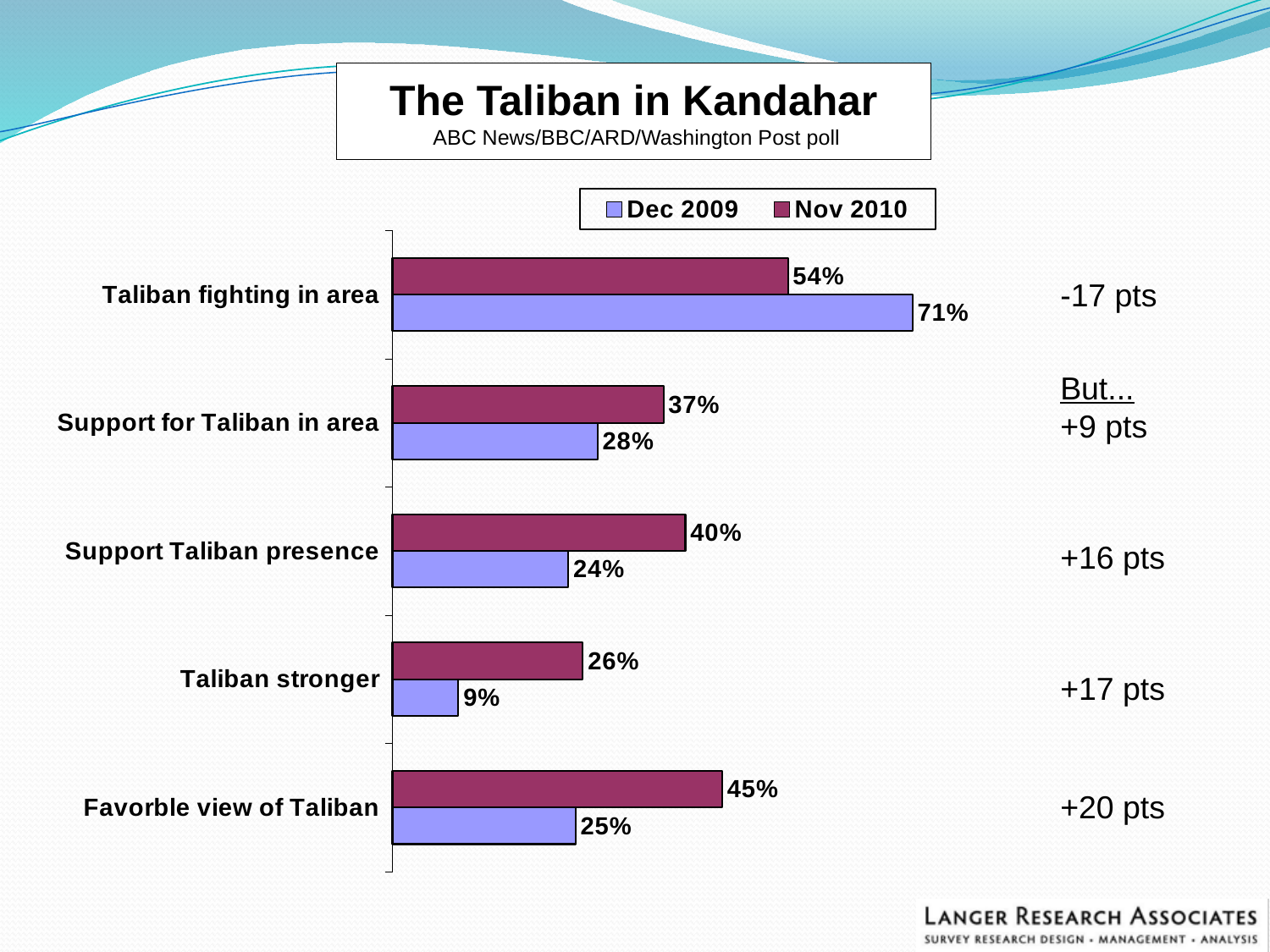
How many series does the legend list? 2 What is the difference between the Dec 2009 and Nov 2010 values for "Support Taliban presence"? 16 percentage points Which category has the lowest Nov 2010 value? Taliban stronger What is the Dec 2009 value for "Taliban stronger"? 9% Which is larger for "Support for Taliban in area": the Dec 2009 value or the Nov 2010 value? Nov 2010 What is the Nov 2010 value for "Favorble view of Taliban"? 45% Which category has the highest Dec 2009 value? Taliban fighting in area How many categories are shown on the chart? 5 What is the title of the chart? The Taliban in Kandahar Which series is shown in the darker purple colour? Nov 2010 What kind of chart is shown on the slide? Bar chart What is the Nov 2010 value for "Taliban fighting in area"? 54%